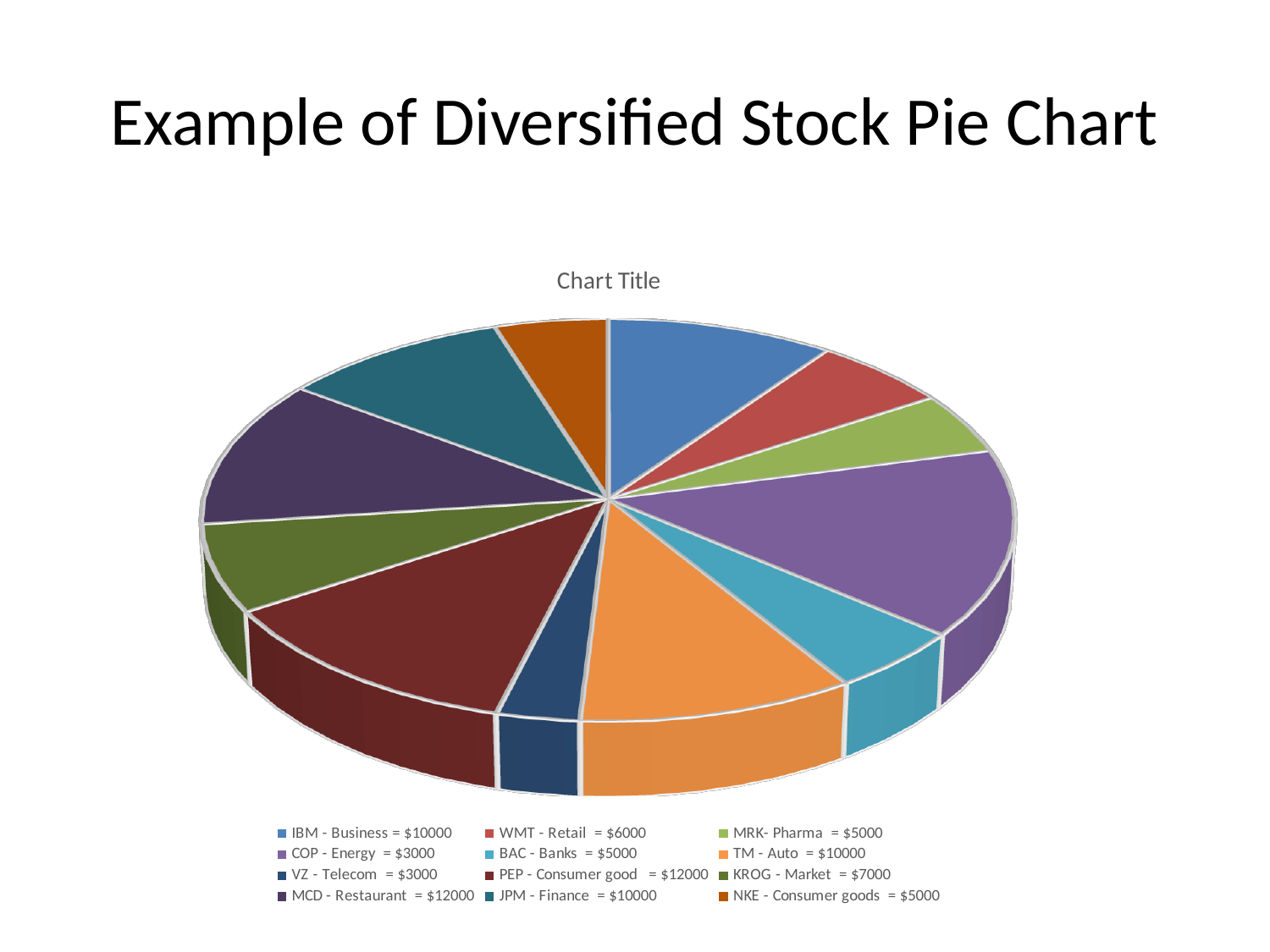
What is the title printed above the pie chart? Chart Title According to the legend, what dollar amount is listed for PEP - Consumer good? $12000 How many entries does the legend list? 12 What kind of chart is shown on the slide? pie chart According to the legend, what dollar amount is listed for KROG - Market? $7000 How many slices (categories) does the pie chart have? 12 Which legend entry is shown in the light green colour? MRK- Pharma = $5000 According to the legend, what dollar amount is listed for WMT - Retail? $6000 Using the legend values, what is the difference between IBM - Business and WMT - Retail? $4000 Using the legend values, which is larger: PEP - Consumer good or VZ - Telecom? PEP - Consumer good According to the legend, what dollar amount is listed for IBM - Business? $10000 According to the legend, what dollar amount is listed for VZ - Telecom? $3000